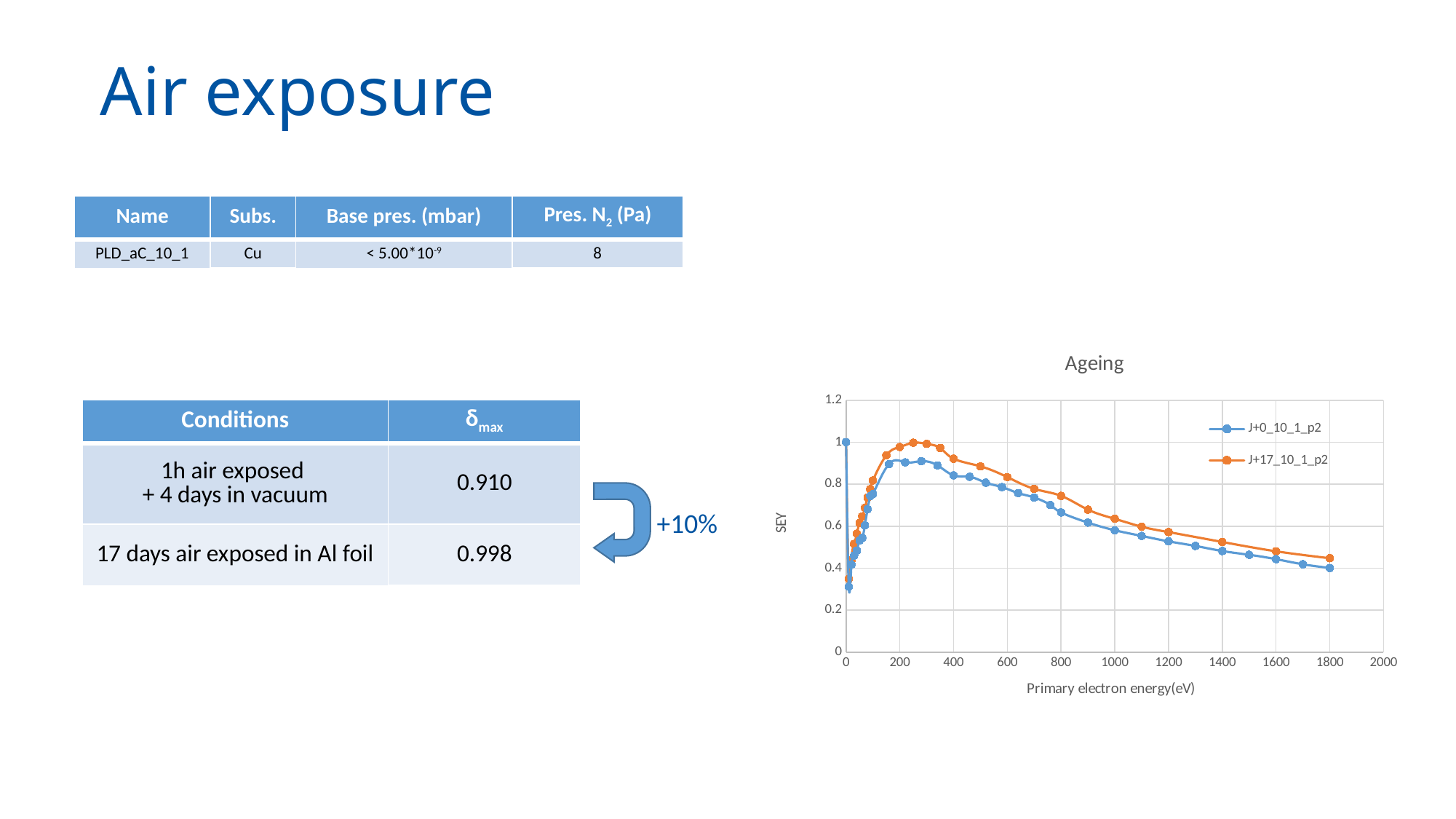
In the "Ageing" chart, does the SEY of J+0_10_1_p2 rise or fall as the primary electron energy increases from 400 eV to 1800 eV? fall What are the two series names listed in the legend of the "Ageing" chart? J+0_10_1_p2 and J+17_10_1_p2 What is the title of the chart on the slide? Ageing How many series does the legend of the "Ageing" chart list? 2 In the "Ageing" chart, which series reaches the higher peak SEY? J+17_10_1_p2 What kind of chart is the "Ageing" chart? line chart In the "Ageing" chart, which series has the higher SEY at 1000 eV? J+17_10_1_p2 In the "Ageing" chart, is the SEY value for J+17_10_1_p2 at 1800 eV greater or less than 0.4? greater In the "Ageing" chart, is the SEY value for J+17_10_1_p2 at 200 eV greater or less than 0.8? greater In the "Ageing" chart, is the SEY value for J+0_10_1_p2 at 1400 eV greater or less than 0.6? less